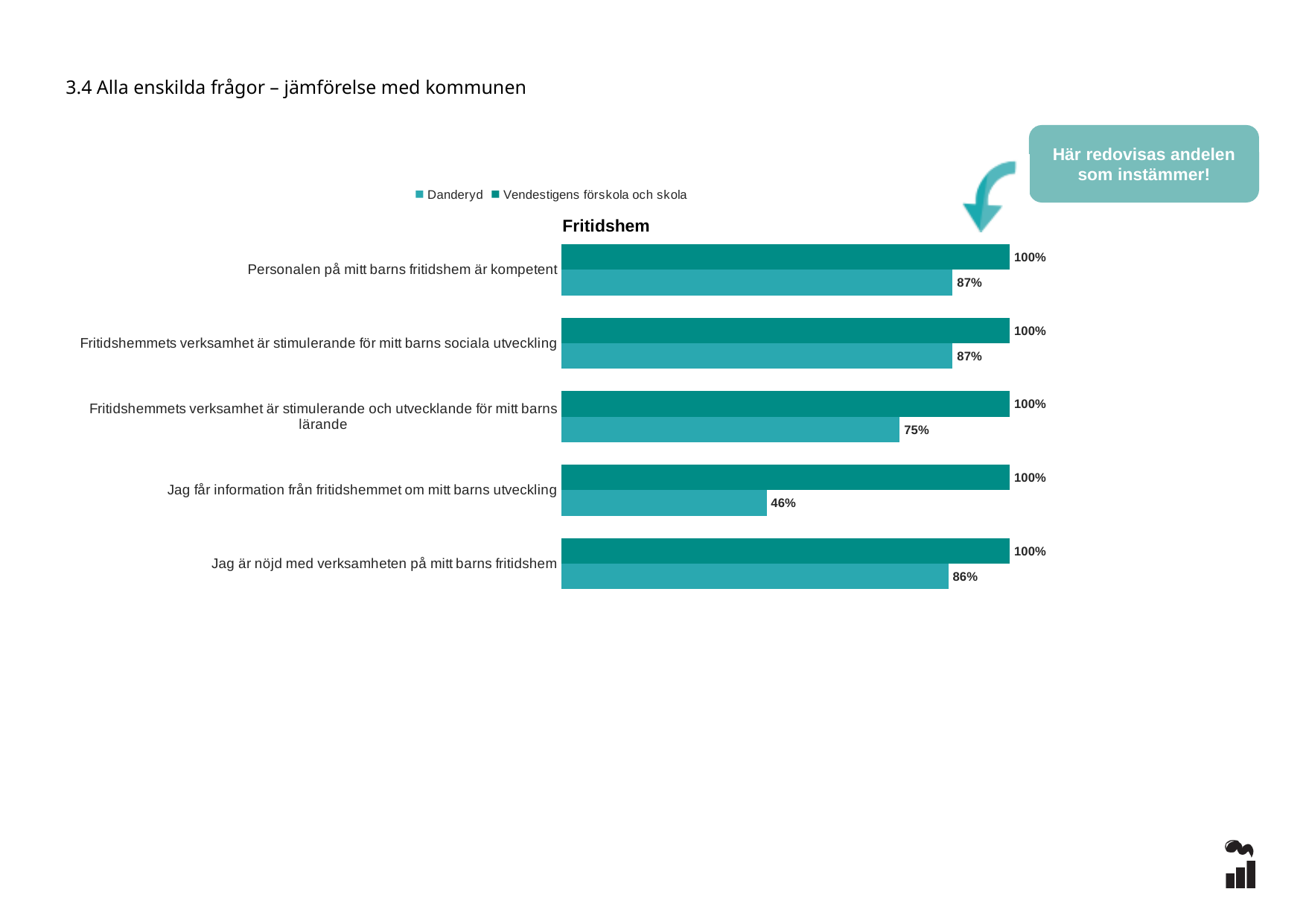
What is the Vendestigens förskola och skola value for "Personalen på mitt barns fritidshem är kompetent"? 100% Which question has the lowest Danderyd value? Jag får information från fritidshemmet om mitt barns utveckling What is the Danderyd value for "Jag får information från fritidshemmet om mitt barns utveckling"? 46% What is the Danderyd value for "Jag är nöjd med verksamheten på mitt barns fritidshem"? 86% What is the difference between the Vendestigens förskola och skola value and the Danderyd value for "Jag får information från fritidshemmet om mitt barns utveckling"? 54% How many questions (categories) are plotted in the chart? 5 For "Fritidshemmets verksamhet är stimulerande för mitt barns sociala utveckling", which series has the larger value, Danderyd or Vendestigens förskola och skola? Vendestigens förskola och skola How many series does the legend list? 2 What is the difference between the Danderyd values for "Personalen på mitt barns fritidshem är kompetent" and "Fritidshemmets verksamhet är stimulerande och utvecklande för mitt barns lärande"? 12% What type of chart is shown on the slide? Bar chart What is the Danderyd value for "Fritidshemmets verksamhet är stimulerande och utvecklande för mitt barns lärande"? 75% What is the title of the chart? Fritidshem